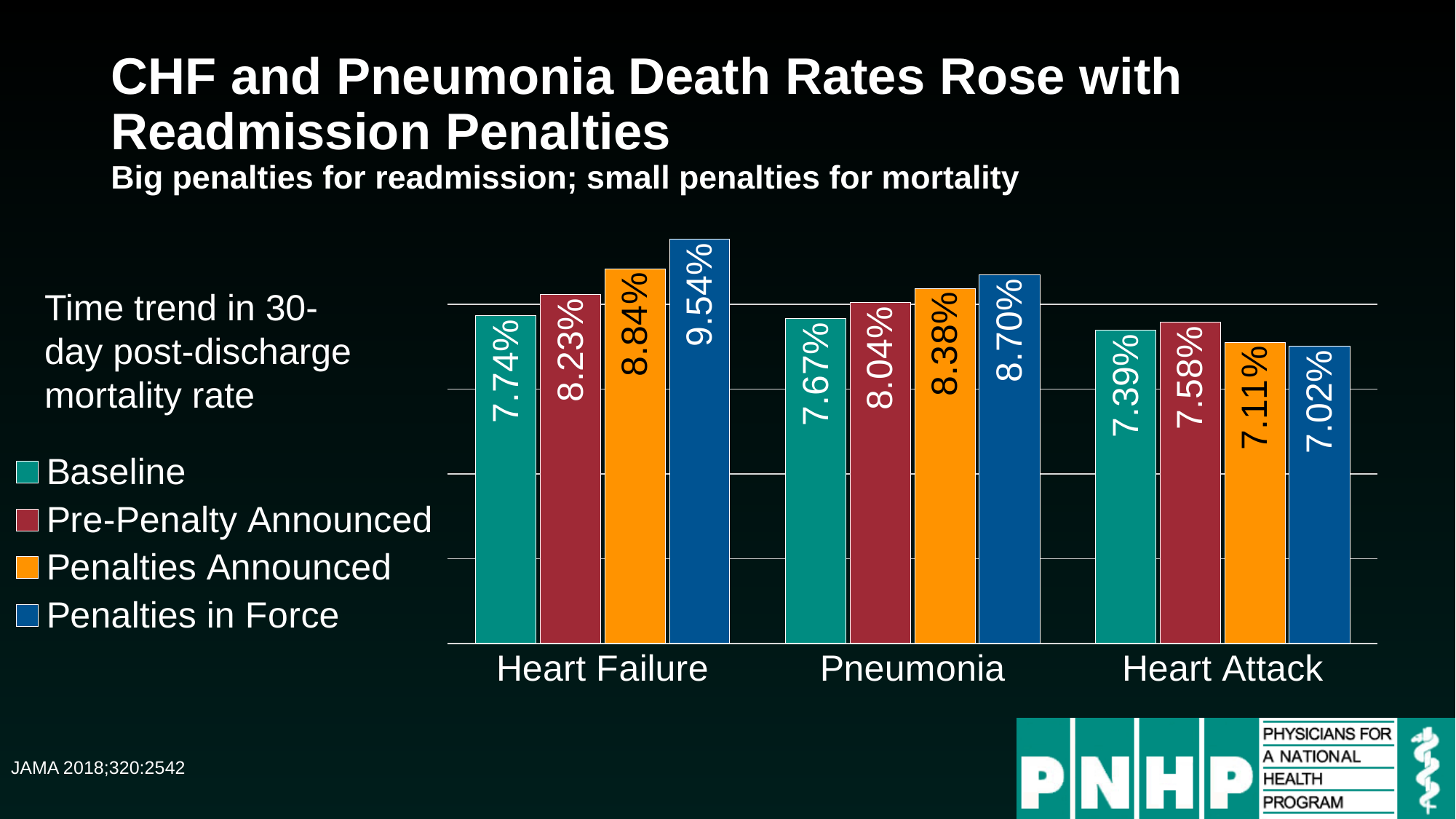
What kind of chart is shown on the slide? Bar chart Do the Heart Attack mortality rates rise or fall from Pre-Penalty Announced to Penalties in Force? Fall Which is larger for Heart Attack: the Pre-Penalty Announced rate or the Penalties in Force rate? Pre-Penalty Announced Which condition has the highest Penalties in Force mortality rate? Heart Failure Which colour represents the Penalties Announced series? Orange Which condition has the lowest Baseline mortality rate? Heart Attack How many series does the legend list? 4 How many conditions are shown on the x axis? 3 What is the Penalties in Force mortality rate for Pneumonia? 8.70% What is the Baseline 30-day mortality rate for Heart Failure? 7.74% What is the Penalties Announced mortality rate for Heart Attack? 7.11% What is the difference between the Penalties in Force and Baseline mortality rates for Heart Failure? 1.80%